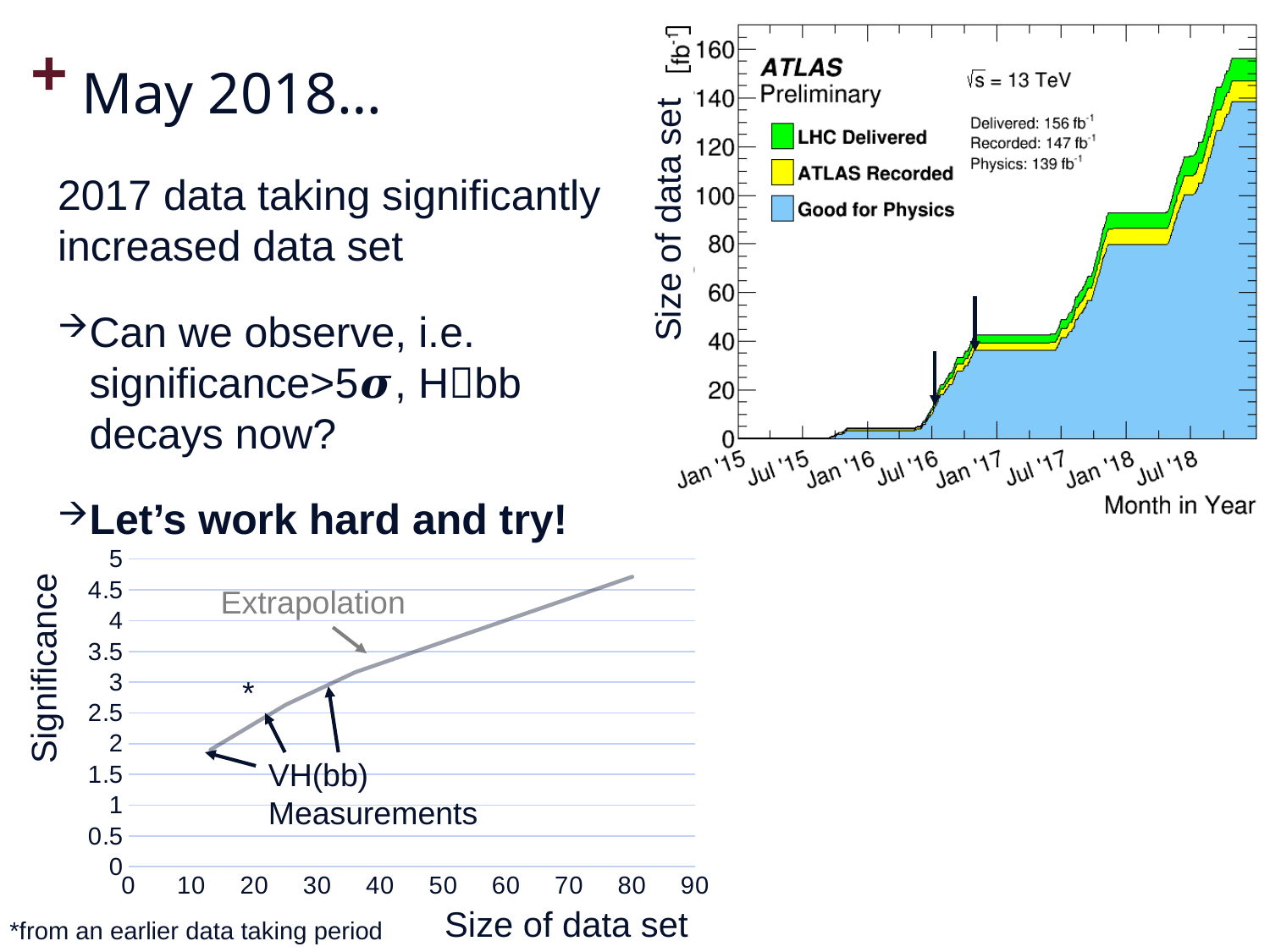
In the Significance chart at the bottom left, is the significance at a data set size of 80 greater or less than 4.5? greater In the ATLAS chart on the right, what is the difference between the Delivered and Recorded values? 9 fb⁻¹ In the ATLAS chart on the right, what is the Recorded value printed on the chart? 147 fb⁻¹ In the ATLAS chart on the right, which is larger, the Recorded value or the Physics value? Recorded In the ATLAS chart on the right, how many series does the legend list? 3 In the Significance chart at the bottom left, what kind of chart is it? line chart In the ATLAS chart on the right, does the size of the data set rise or fall from Jan '15 to Jul '18? rise In the ATLAS chart on the right, what is the label of the x axis? Month in Year In the ATLAS chart on the right, what is the Delivered value printed on the chart? 156 fb⁻¹ In the Significance chart at the bottom left, does significance rise or fall as the size of the data set increases? rise In the ATLAS chart on the right, what is the Physics value printed on the chart? 139 fb⁻¹ In the Significance chart at the bottom left, is the significance at a data set size of 20 greater or less than 3? less